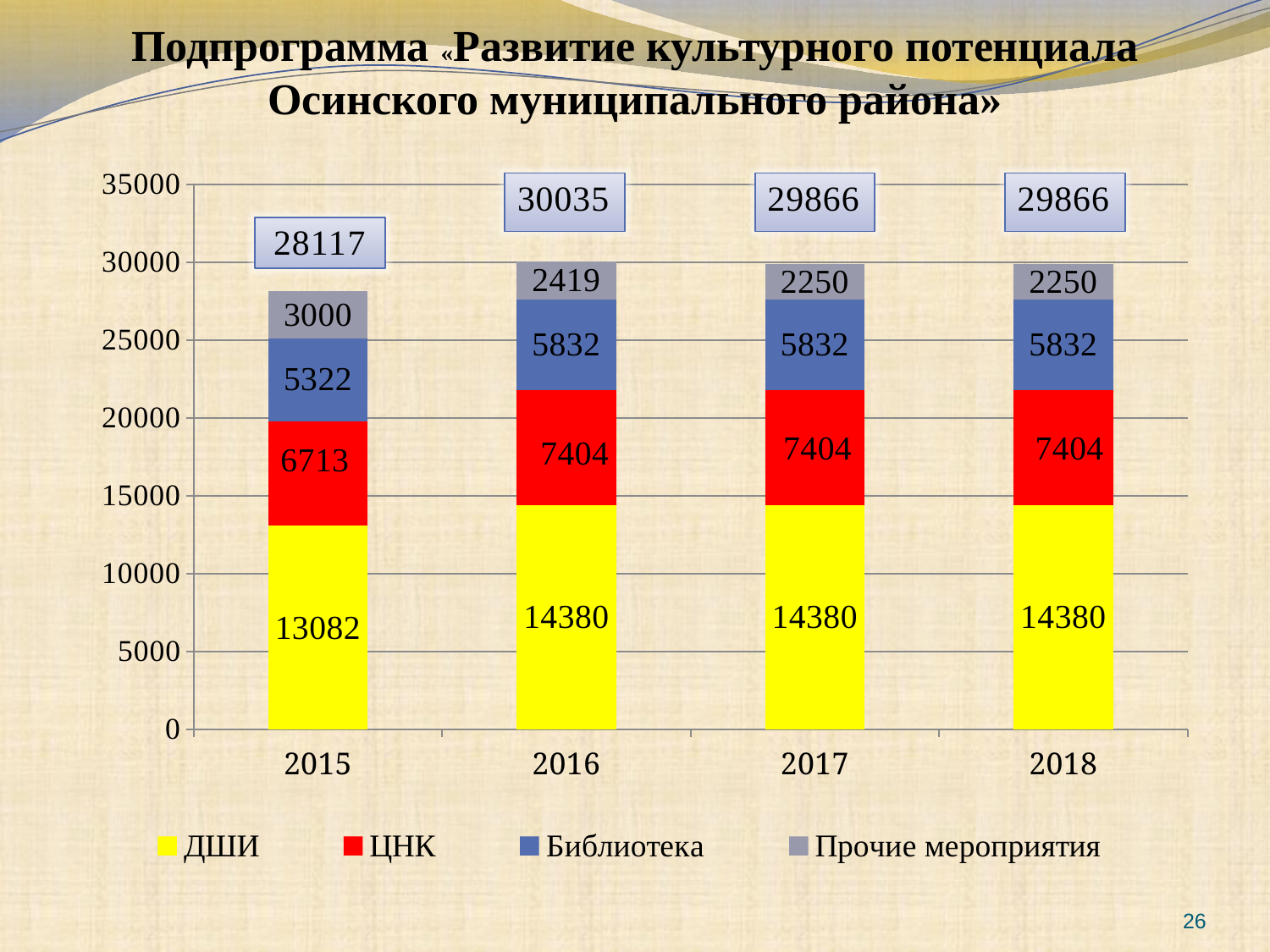
What is the value for ДШИ in 2015? 13082 How many series does the legend list? 4 What is the value for Библиотека in 2015? 5322 How many years (categories) are shown on the x axis? 4 Which year has the highest total? 2016 What is the value for Прочие мероприятия in 2017? 2250 What is the difference between the Прочие мероприятия values for 2015 and 2016? 581 What is the total of the stacked bar for 2015? 28117 Which is larger: the ЦНК value in 2015 or the ЦНК value in 2017? 2017 What is the total of the stacked bar for 2016? 30035 What is the value for ЦНК in 2016? 7404 What type of chart is shown on the slide? stacked bar chart